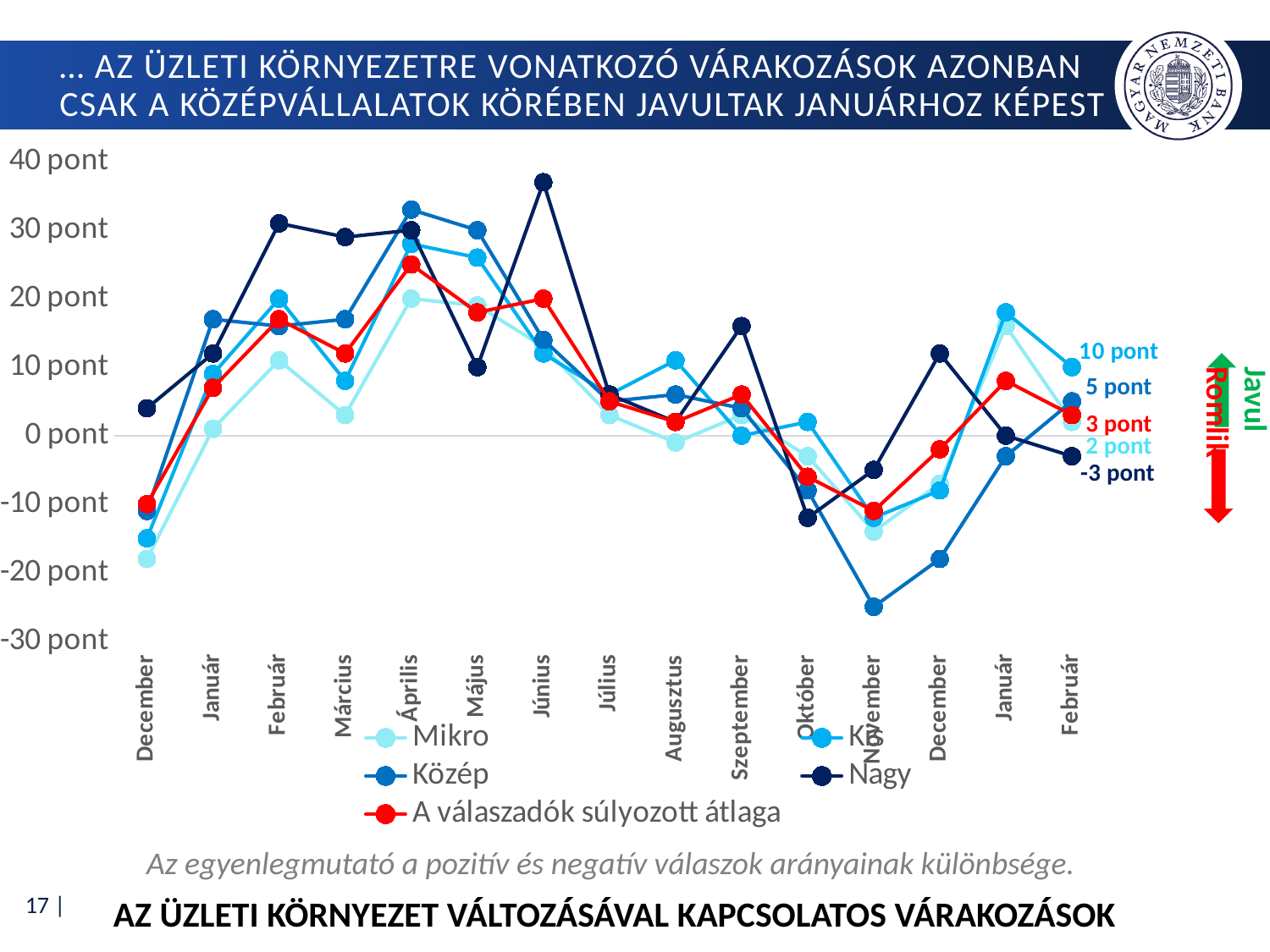
What is the difference between the Kis and Közép values at the final Február point? 5 pont How many months are shown along the x axis? 15 Which series has the lowest value at the final Február point? Nagy What is the value of the Kis series at the final Február point? 10 pont Is the value of the Nagy series in Június greater or less than 30 pont? greater Which series has the highest value at the final Február point? Kis Does the Közép series rise or fall from Október to November? fall Is the value of the Közép series in November greater or less than -20 pont? less How many series does the legend list? 5 What is the value of 'A válaszadók súlyozott átlaga' at the final Február point? 3 pont What is the value of the Nagy series at the final Február point? -3 pont What type of chart is shown on the slide? line chart